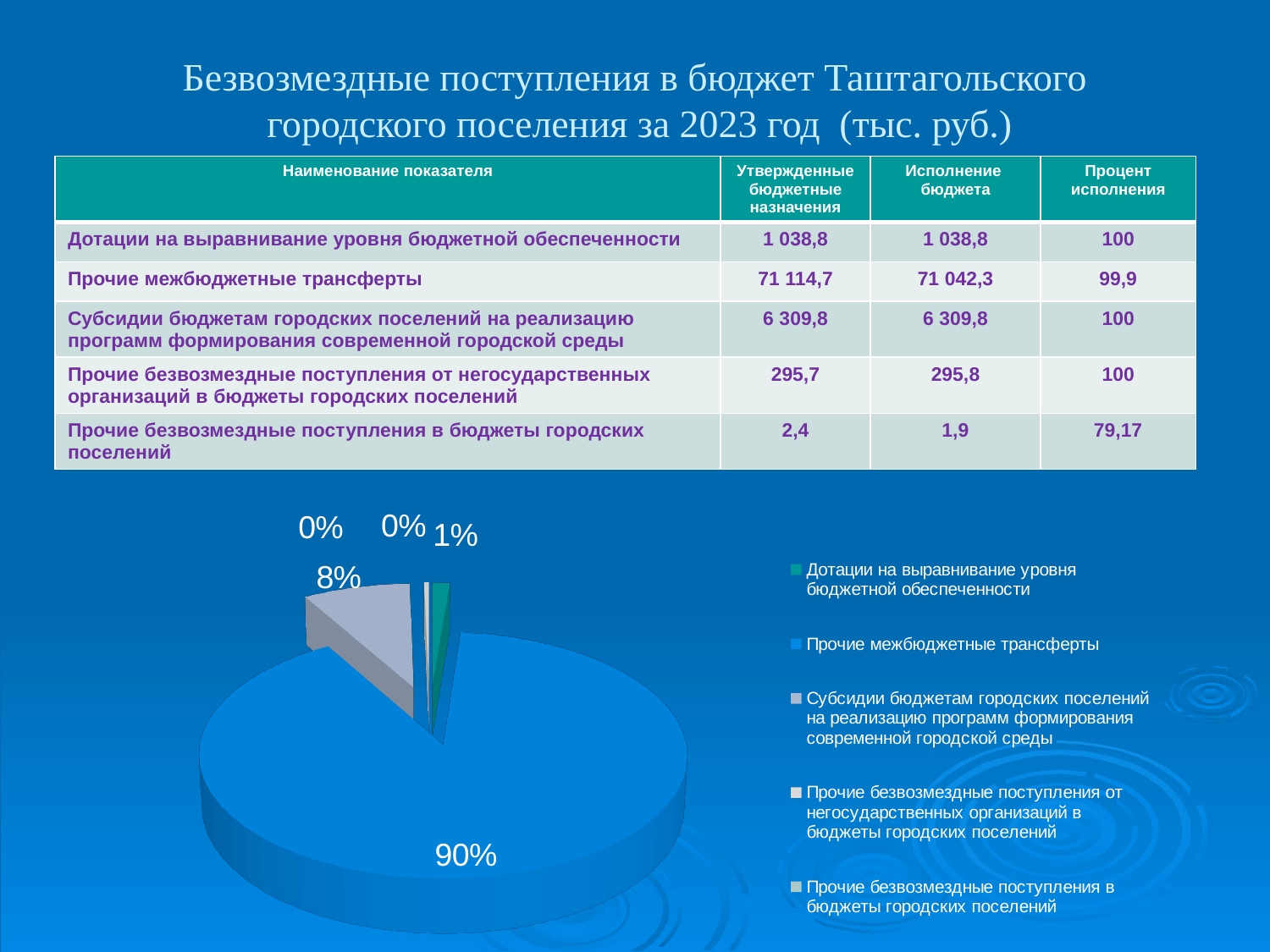
What kind of chart is shown on the slide? pie chart How many percentage labels are shown on the pie chart? 5 What is the difference in percentage points between the 90% slice and the 8% slice of the pie chart? 82 What share of the pie chart does the largest slice represent? 90% What share of the pie chart is labelled for Дотации на выравнивание уровня бюджетной обеспеченности? 1% Which legend category corresponds to the 90% slice of the pie chart? Прочие межбюджетные трансферты Which is larger in the pie chart: the slice for Прочие межбюджетные трансферты or the slice for Субсидии бюджетам городских поселений? Прочие межбюджетные трансферты What share of the pie chart is labelled for the grey slice (Субсидии бюджетам городских поселений на реализацию программ формирования современной городской среды)? 8% How many entries does the legend of the pie chart list? 5 What colour is the largest slice of the pie chart? blue How many slices of the pie chart are labelled 0%? 2 Which legend entry is listed last in the pie chart legend? Прочие безвозмездные поступления в бюджеты городских поселений